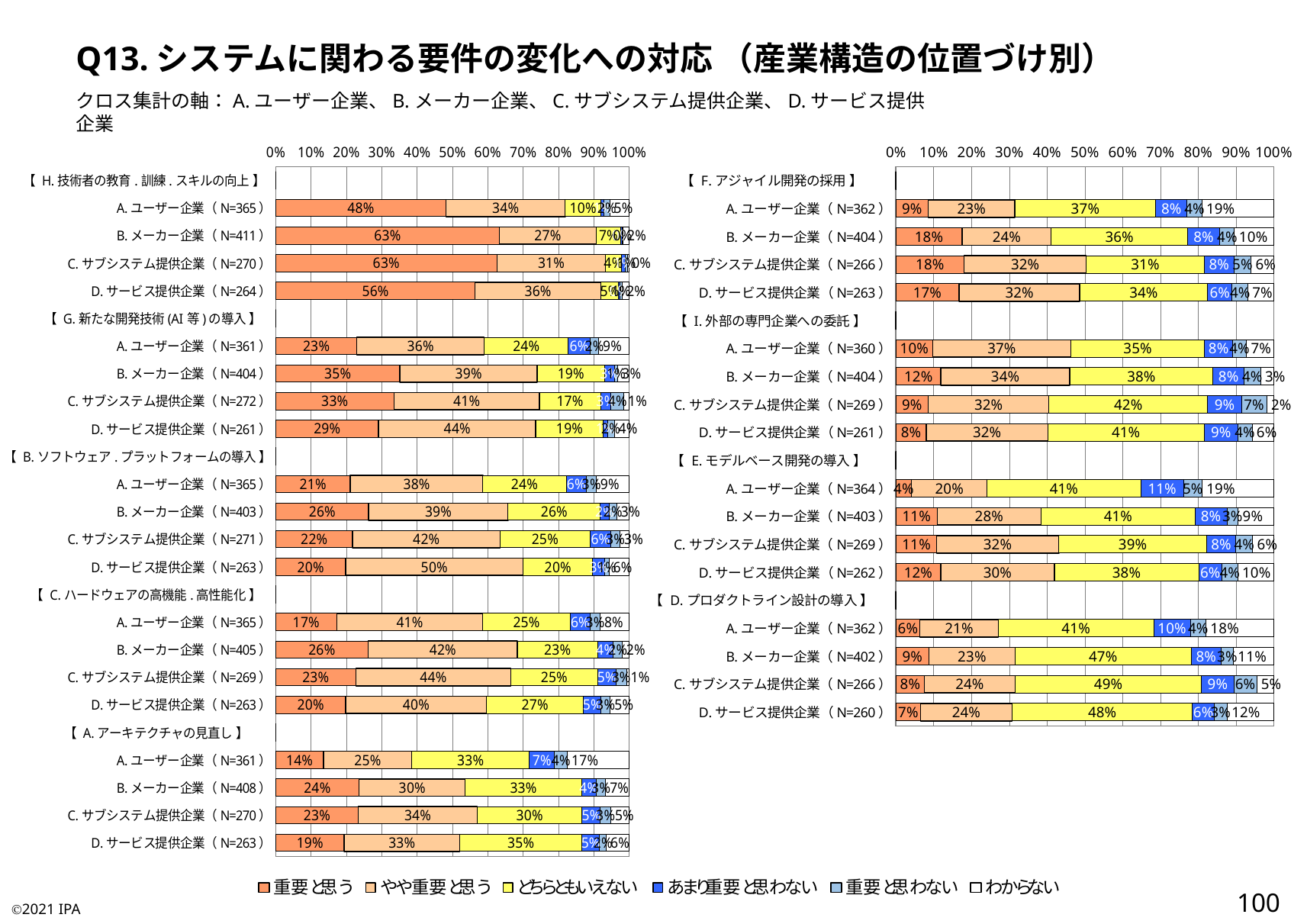
In the left chart, under B. ソフトウェア・プラットフォームの導入, what is the やや重要と思う value for D. サービス提供企業 (N=263)? 50% In the right chart, under E. モデルベース開発の導入, what is the あまり重要と思わない value for A. ユーザー企業 (N=364)? 11% In the left chart, under H. 技術者の教育・訓練・スキルの向上, what is the 重要と思う value for B. メーカー企業 (N=411)? 63% In the left chart, under G. 新たな開発技術(AI等)の導入, what is the difference between the 重要と思う values for B. メーカー企業 (35%) and A. ユーザー企業 (23%)? 12% In the right chart, under D. プロダクトライン設計の導入, what is the どちらともいえない value for C. サブシステム提供企業 (N=266)? 49% How many series does the legend at the bottom of the slide list? 6 In the left chart, under C. ハードウェアの高機能・高性能化, what is the 重要と思う value for A. ユーザー企業 (N=365)? 17% In the right chart, under F. アジャイル開発の採用, which company type has the highest 重要と思う value? B. メーカー企業 and C. サブシステム提供企業 (18%) In the right chart, under I. 外部の専門企業への委託, which is larger: the どちらともいえない value for C. サブシステム提供企業 or for A. ユーザー企業? C. サブシステム提供企業 (42%) In the left chart, under A. アーキテクチャの見直し, what is the わからない value for A. ユーザー企業 (N=361)? 17% What kind of chart is shown on the left side of the slide? Stacked bar chart In the left chart, under H. 技術者の教育・訓練・スキルの向上, what is the 重要と思う value for A. ユーザー企業 (N=365)? 48%